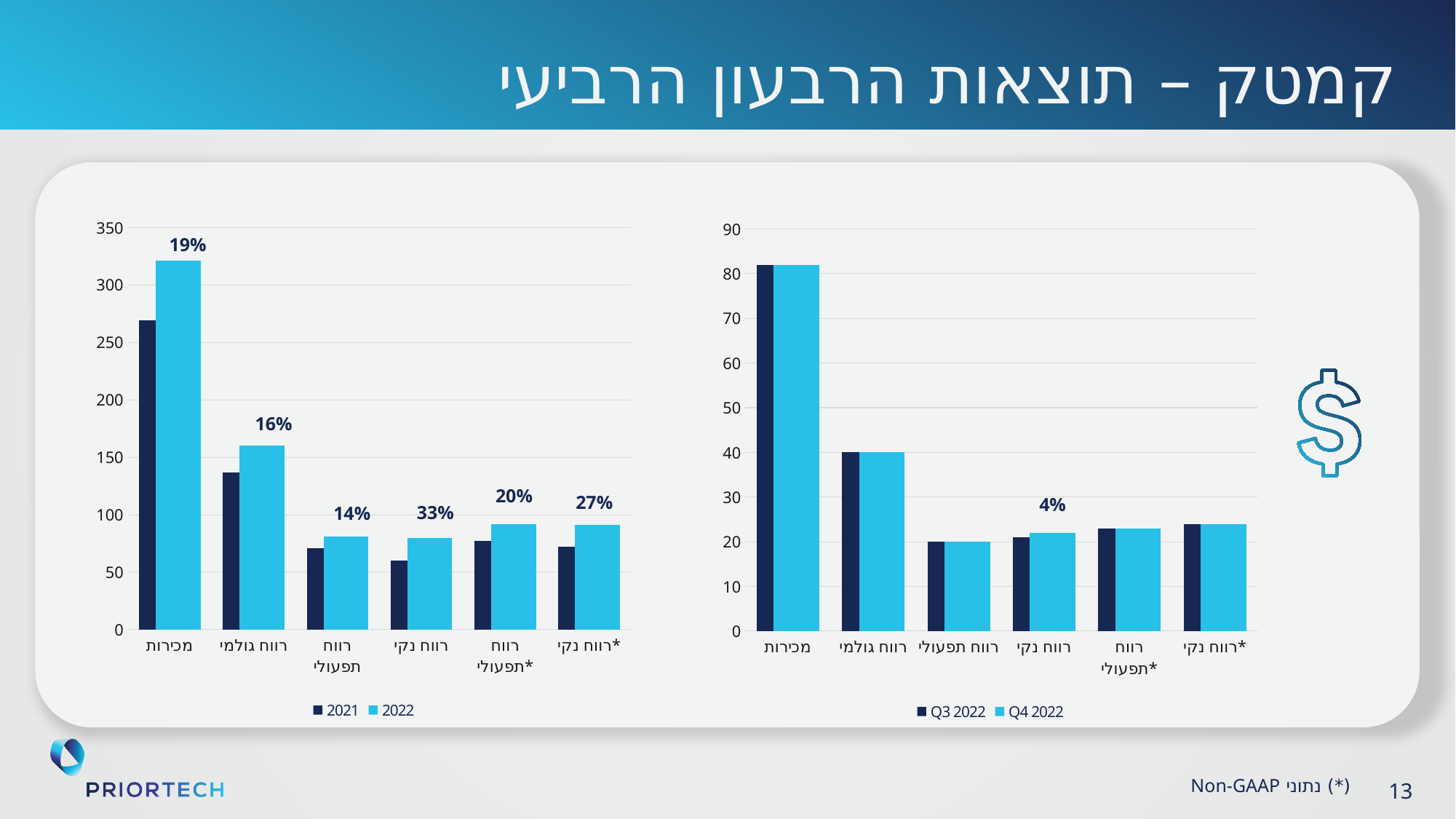
On the left chart (2021 vs 2022), which category has the highest bars? מכירות On the left chart (2021 vs 2022), is the 2022 value for מכירות greater or less than 300? greater On the left chart (2021 vs 2022), is the 2021 value for רווח נקי greater or less than 100? less On the left chart (2021 vs 2022), what percentage label is shown for רווח נקי*? 27% On the right chart (Q3 2022 vs Q4 2022), is the Q4 2022 value for מכירות greater or less than 80? greater How many series does the legend of the right chart (Q3 2022 vs Q4 2022) list? 2 What type of chart is the left chart (2021 vs 2022)? bar chart On the right chart (Q3 2022 vs Q4 2022), what percentage label is shown for רווח נקי? 4% On the left chart (2021 vs 2022), what growth percentage is labelled above the מכירות bars? 19% On the right chart (Q3 2022 vs Q4 2022), which is larger for רווח גולמי: the Q3 2022 bar or the מכירות Q3 2022 bar? מכירות Q3 2022 On the left chart (2021 vs 2022), what percentage label is shown for רווח נקי? 33% How many categories are shown on the x axis of the left chart (2021 vs 2022)? 6